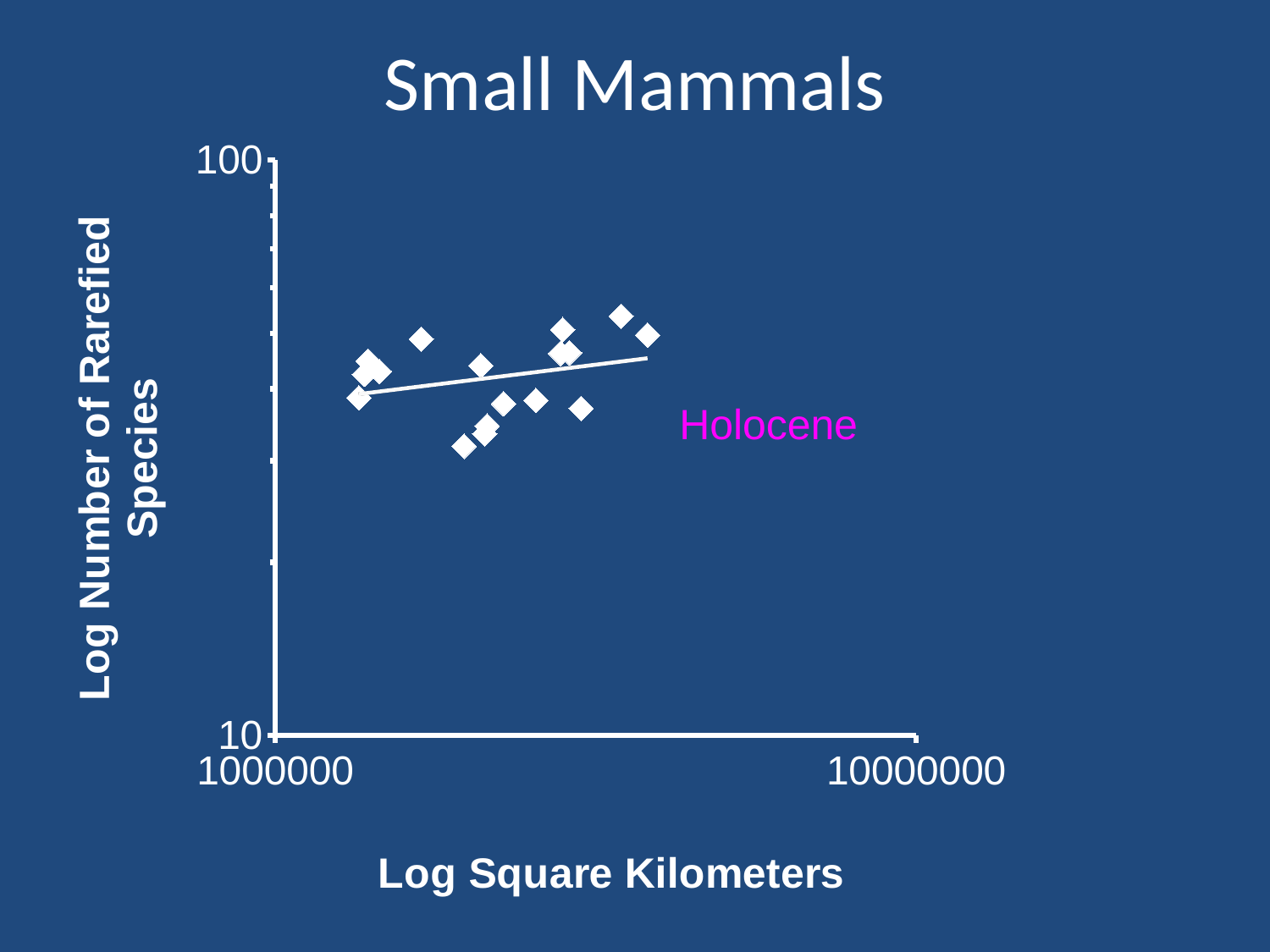
Does the trend line in the chart rise or fall as the x axis increases? rise Are the plotted values for the Holocene points greater or less than 100 on the y axis? less What is the rightmost value shown on the x axis of the chart? 10000000 Are the plotted values for the Holocene points greater or less than 10 on the y axis? greater What is the highest value shown on the y axis of the chart? 100 What is the lowest value shown on the y axis of the chart? 10 What is the label on the x axis of the chart? Log Square Kilometers What is the leftmost value shown on the x axis of the chart? 1000000 What kind of chart is shown on the slide? scatter plot What is the title of the chart? Small Mammals